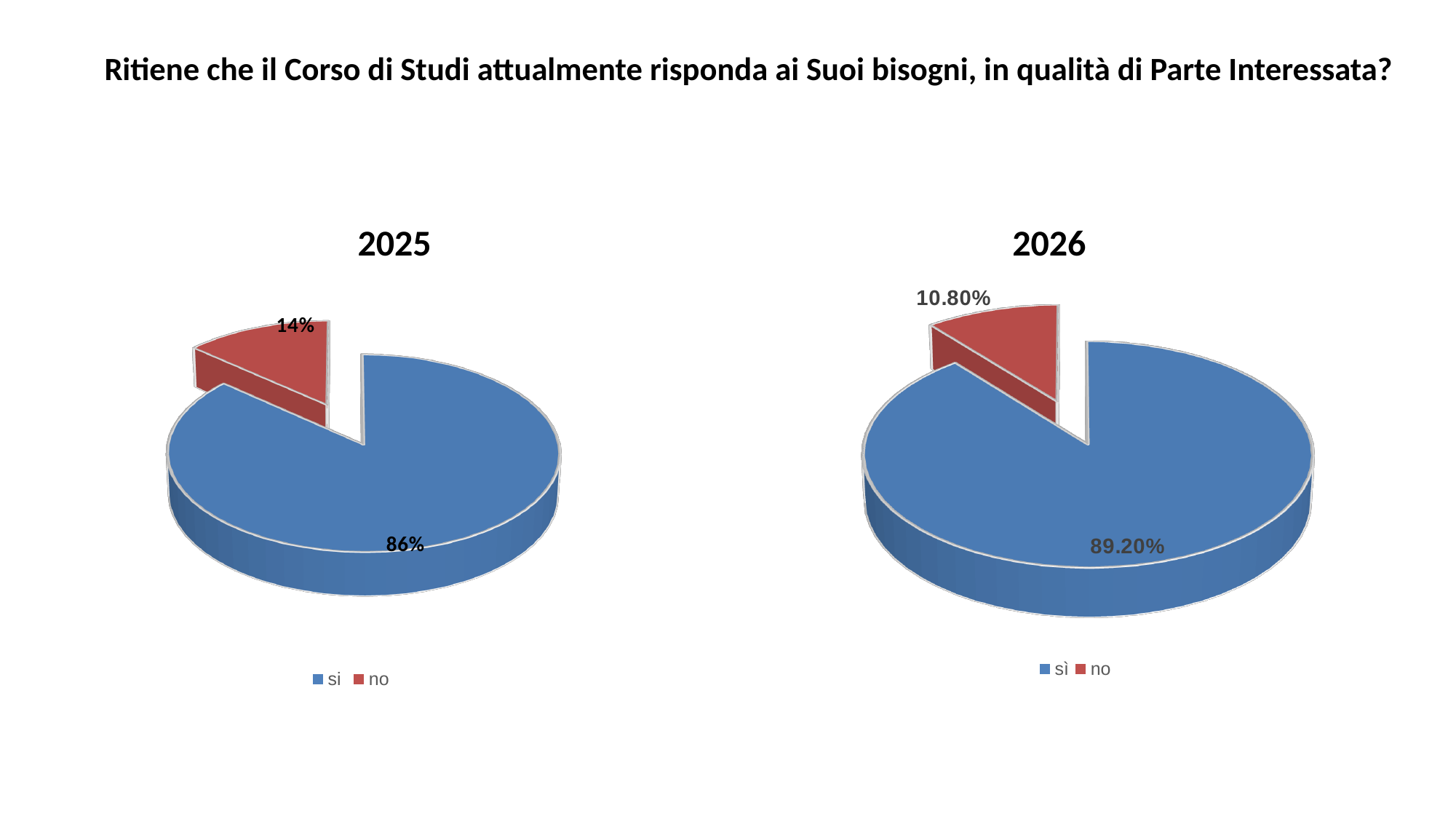
How many slices does the 2025 chart have? 2 In the 2025 chart, what is the difference between the 'si' and 'no' shares? 72% In the 2025 chart, which category has the largest slice? si In the 2025 chart, what share of responses is 'no'? 14% In the 2025 chart, what share of responses is 'si'? 86% In the 2026 chart, what share of responses is 'no'? 10.80% In the 2026 chart, what share of responses is 'sì'? 89.20% How many entries does the legend of the 2026 chart list? 2 Is the 'no' share larger in the 2025 chart or in the 2026 chart? 2025 In the 2025 chart, what colour is the 'no' slice? Red What kind of chart is the 2026 chart? Pie chart In the 2026 chart, which category has the smallest slice? no